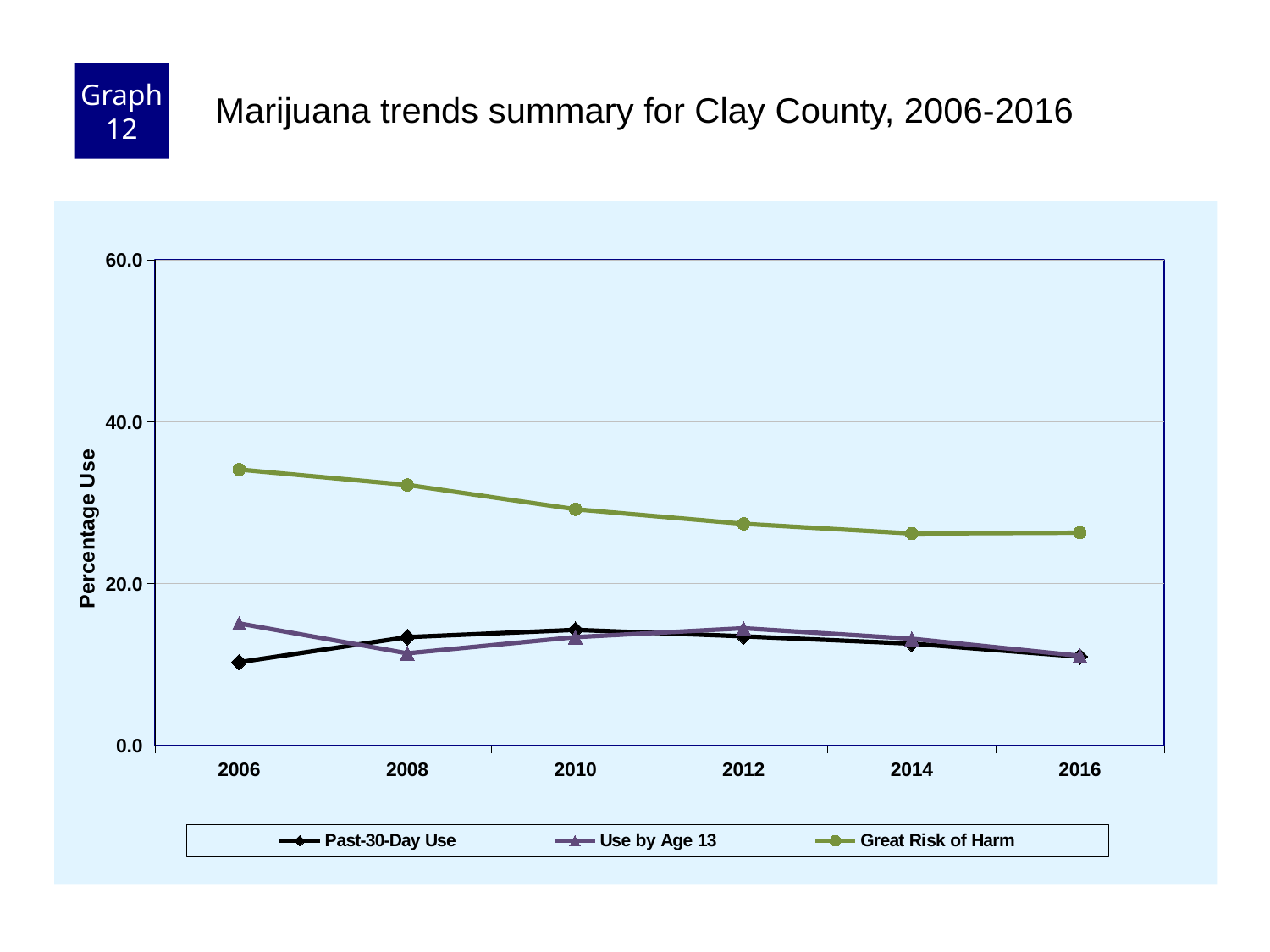
What is the title of the chart? Marijuana trends summary for Clay County, 2006-2016 In 2008, which is larger: Past-30-Day Use or Use by Age 13? Past-30-Day Use How many series does the legend list? 3 What kind of chart is shown on the slide? line chart What is the label on the y axis? Percentage Use How many years are plotted along the x axis? 6 Is the Past-30-Day Use value for 2010 greater or less than 20.0? less Does the Great Risk of Harm series rise or fall from 2006 to 2016? fall In which year is the Great Risk of Harm value highest? 2006 Is the Great Risk of Harm value for 2006 greater or less than 40.0? less In 2006, which is larger: Use by Age 13 or Past-30-Day Use? Use by Age 13 Is the Great Risk of Harm value for 2016 greater or less than 20.0? greater